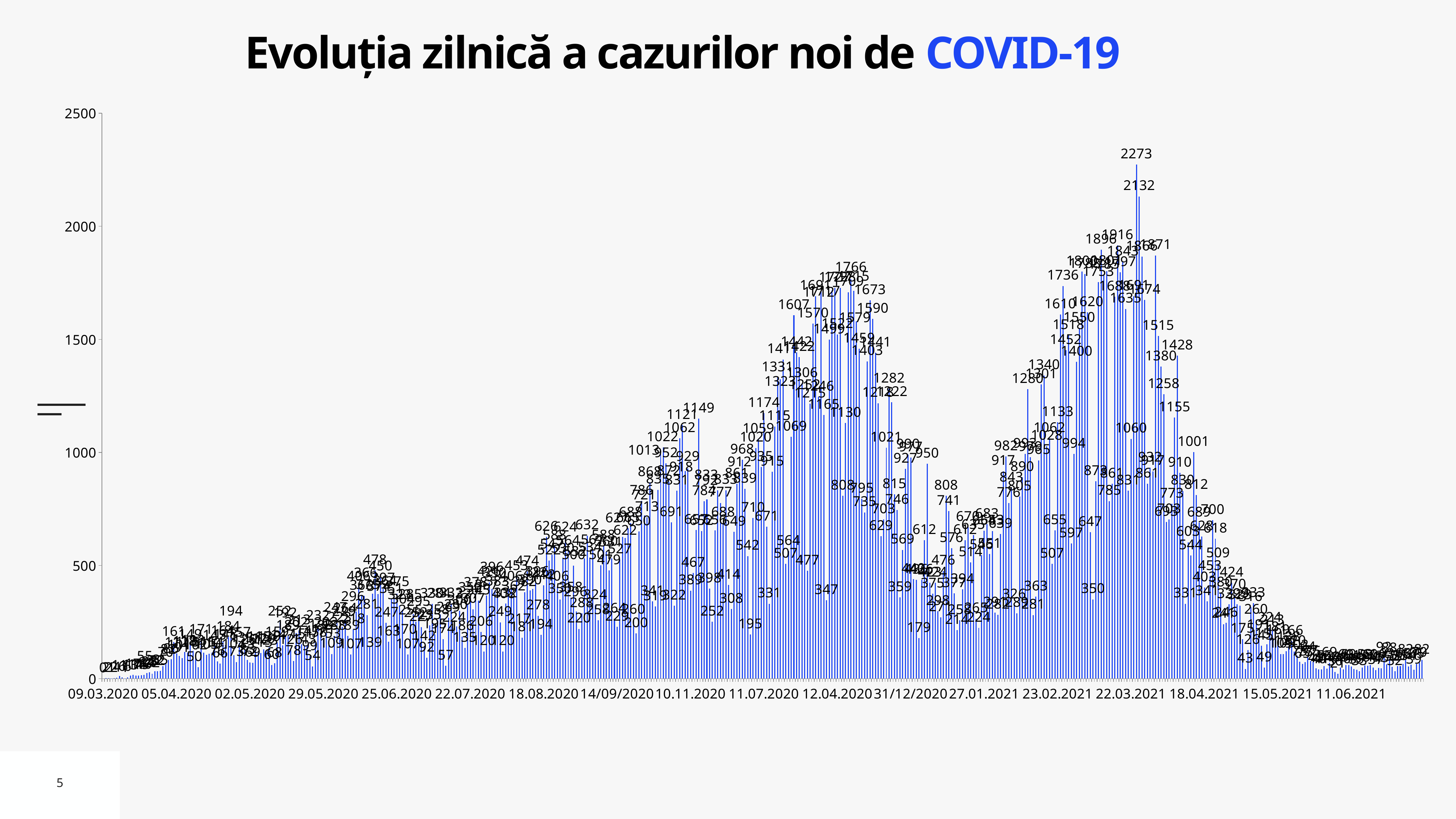
What kind of chart is shown on the slide? bar chart Is the highest value on the chart greater or less than 2000? greater Do the values rise or fall along the x axis between 15.05.2021 and 11.06.2021? fall What is the second highest value labelled on the chart? 2132 How many data series are plotted on the chart? 1 What is the highest tick value shown on the vertical axis? 2500 What is the difference between the two highest labelled values on the chart (2273 and 2132)? 141 What is the title of the chart? Evoluția zilnică a cazurilor noi de COVID-19 Is the value for 11.06.2021 greater or less than 500? less What is the highest value labelled on the chart? 2273 Is the value for 09.03.2020 greater or less than 500? less Do the values rise or fall along the x axis between 09.03.2020 and 05.04.2020? rise